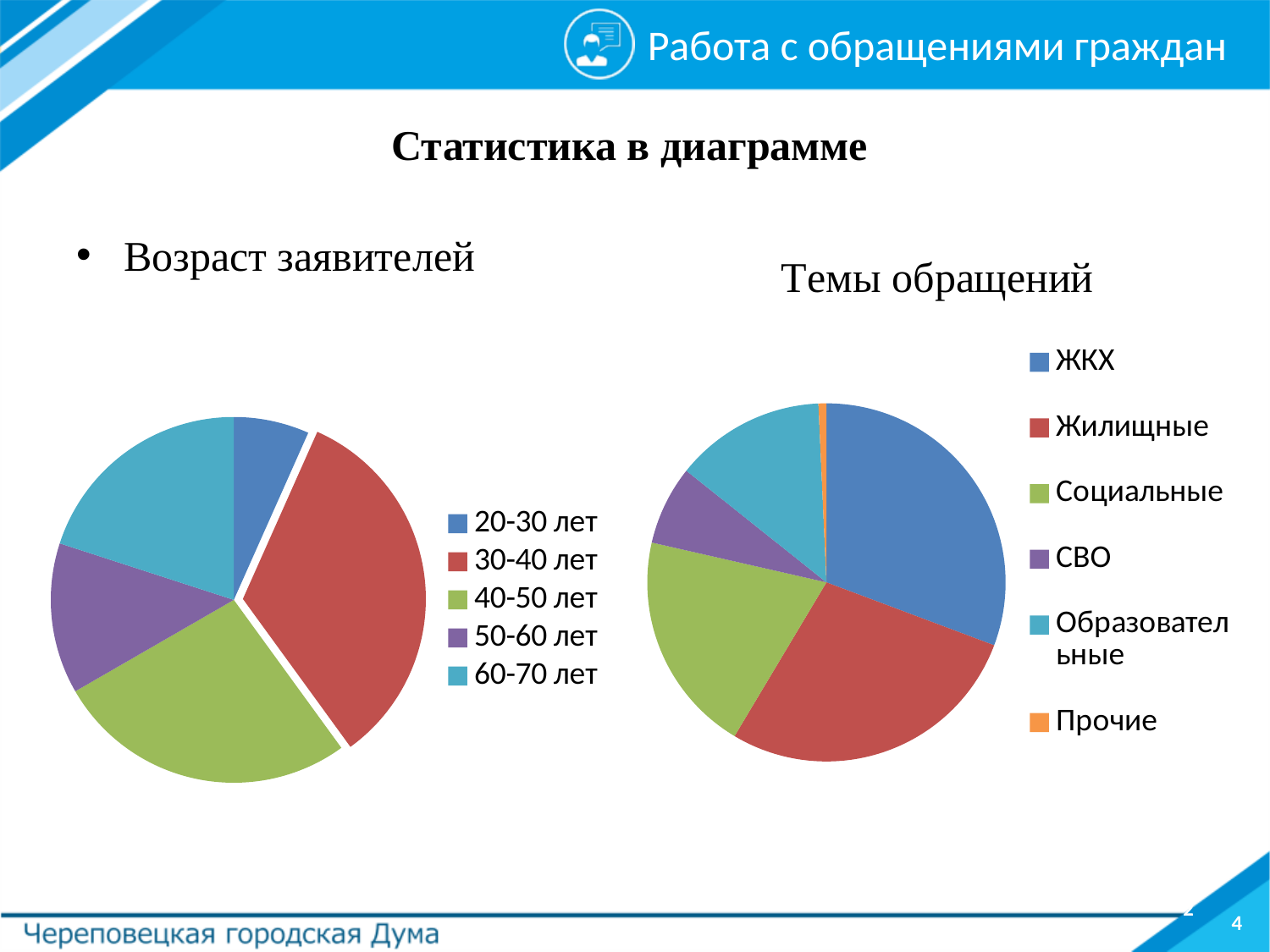
In the "Возраст заявителей" chart, which age group has the largest slice? 30-40 лет In the "Темы обращений" chart, which slice is larger: СВО or Образовательные? Образовательные In the "Темы обращений" chart, which topic has the smallest slice? Прочие What type of chart is the "Темы обращений" chart? pie chart In the "Темы обращений" chart, which topic has the largest slice? ЖКХ In the "Возраст заявителей" chart, which colour represents the 60-70 лет category? teal (light blue) In the "Возраст заявителей" chart, which slice is larger: 40-50 лет or 50-60 лет? 40-50 лет In the "Возраст заявителей" chart, which age group has the smallest slice? 20-30 лет In the "Темы обращений" chart, how many categories does the legend list? 6 What type of chart is the "Возраст заявителей" chart? pie chart In the "Возраст заявителей" chart, how many categories does the legend list? 5 In the "Темы обращений" chart, which colour represents the Прочие category? orange